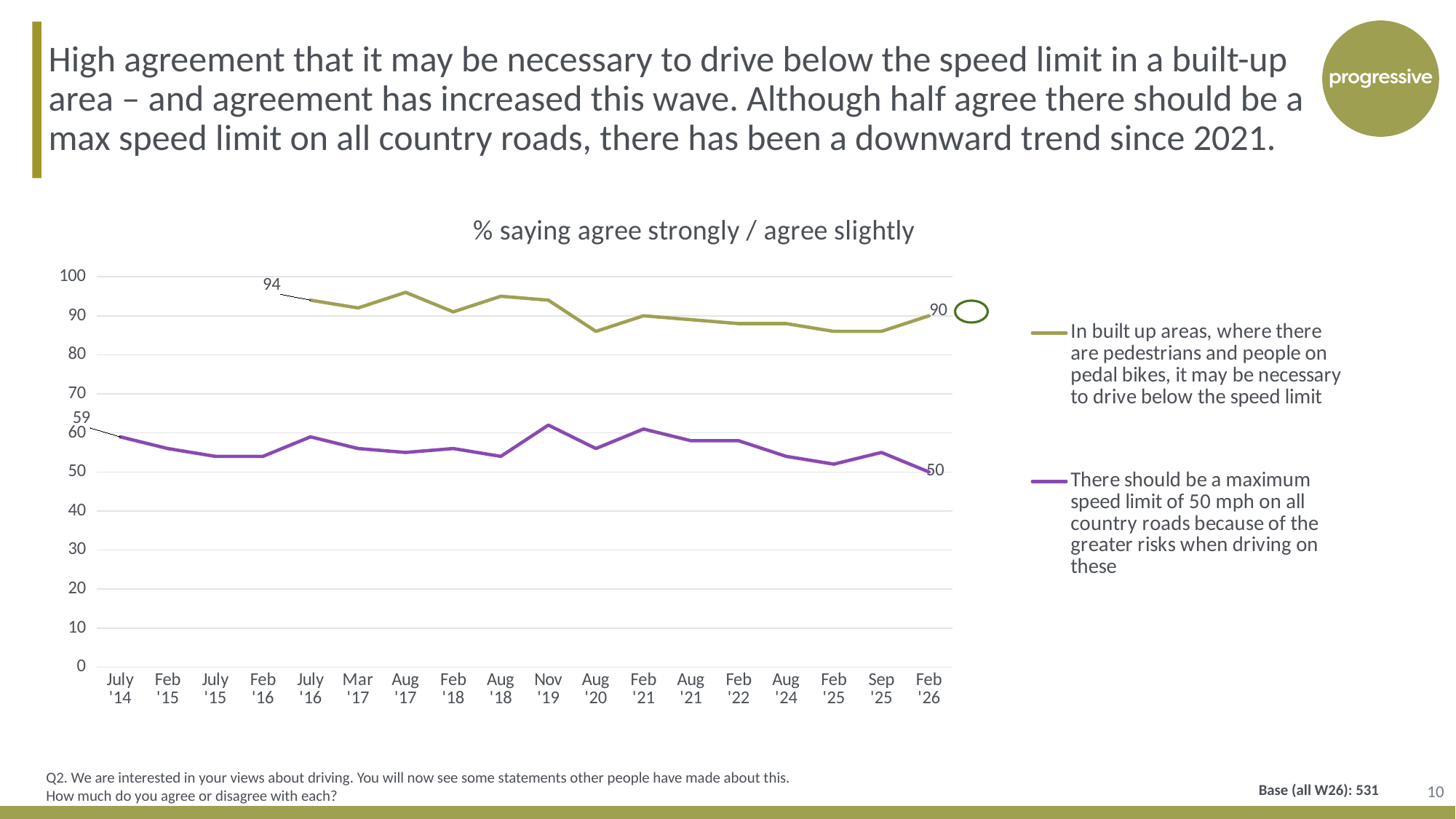
How many series does the legend list? 2 What is the value for Feb '26 for the series 'There should be a maximum speed limit of 50 mph on all country roads because of the greater risks when driving on these'? 50 What is the value for July '14 for the series 'There should be a maximum speed limit of 50 mph on all country roads'? 59 What is the difference between the two series' values at Feb '26? 40 At Feb '26, which series has the larger value: 'In built up areas ... drive below the speed limit' or 'There should be a maximum speed limit of 50 mph on all country roads'? In built up areas ... drive below the speed limit Is the value for Aug '20 for the series 'In built up areas ... drive below the speed limit' greater or less than 80? greater What is the value for Feb '26 for the series 'In built up areas, where there are pedestrians and people on pedal bikes, it may be necessary to drive below the speed limit'? 90 What is the title of the chart? % saying agree strongly / agree slightly What type of chart is shown on the slide? line chart How many time points are shown on the x axis? 18 Is the value for Nov '19 for the series 'There should be a maximum speed limit of 50 mph on all country roads' greater or less than 70? less What is the labelled value at July '16 for the series 'In built up areas ... it may be necessary to drive below the speed limit'? 94